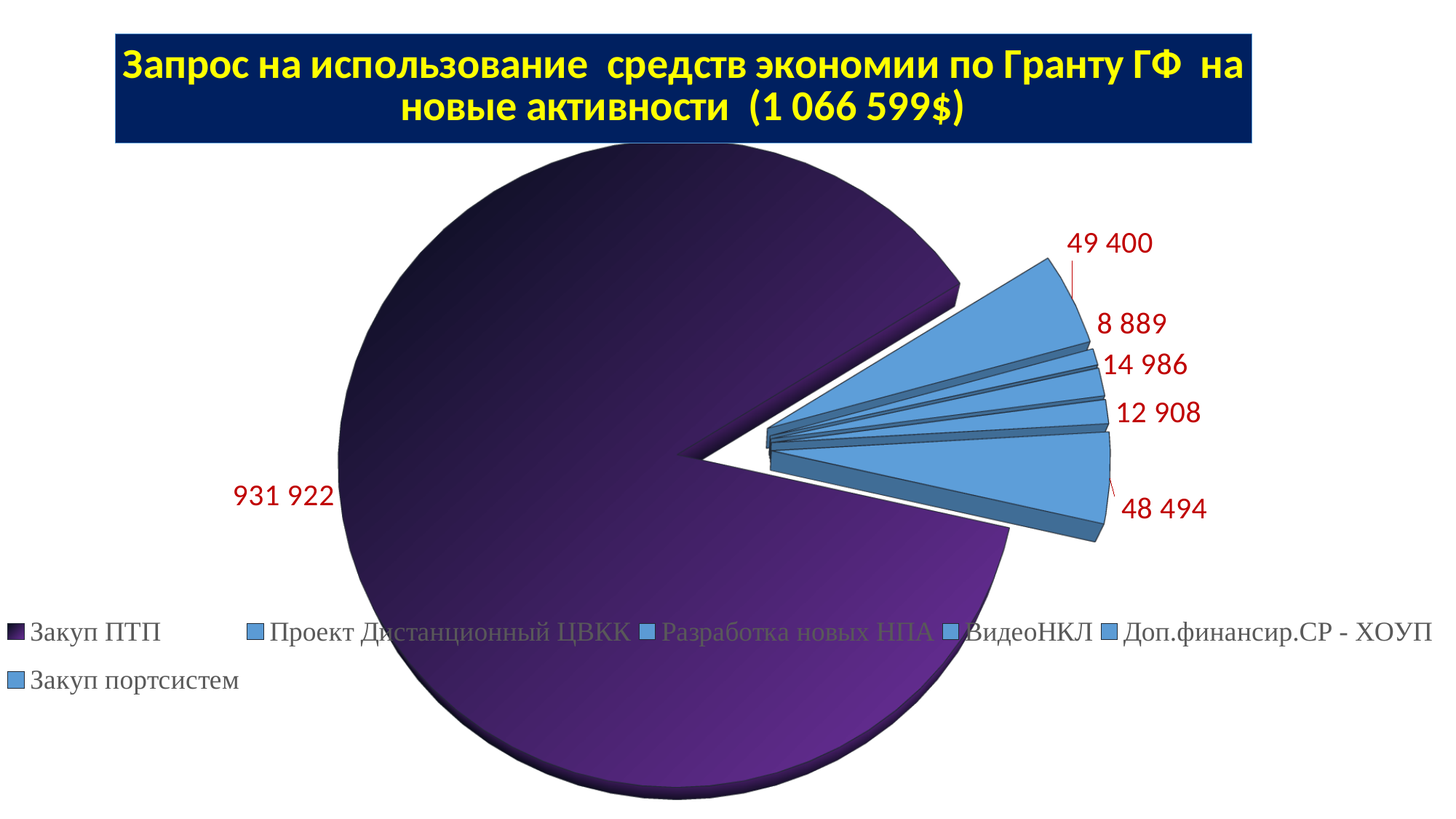
What is the smallest value labelled on the pie chart? 8 889 How many slices does the pie chart have? 6 What is the value of the Закуп ПТП slice? 931 922 What is the title of the chart? Запрос на использование средств экономии по Гранту ГФ на новые активности (1 066 599$) What kind of chart is shown on the slide? pie chart What is the total of all the values labelled on the pie chart? 1 066 599 What share of the pie does the Закуп ПТП slice represent? 87.4% What is the difference between the Закуп ПТП slice (931 922) and the slice labelled 49 400? 882 522 What is the difference between the slices labelled 14 986 and 12 908? 2 078 Which is larger, the slice labelled 49 400 or the slice labelled 48 494? 49 400 What is the difference between the slices labelled 49 400 and 48 494? 906 Which category has the largest slice of the pie? Закуп ПТП